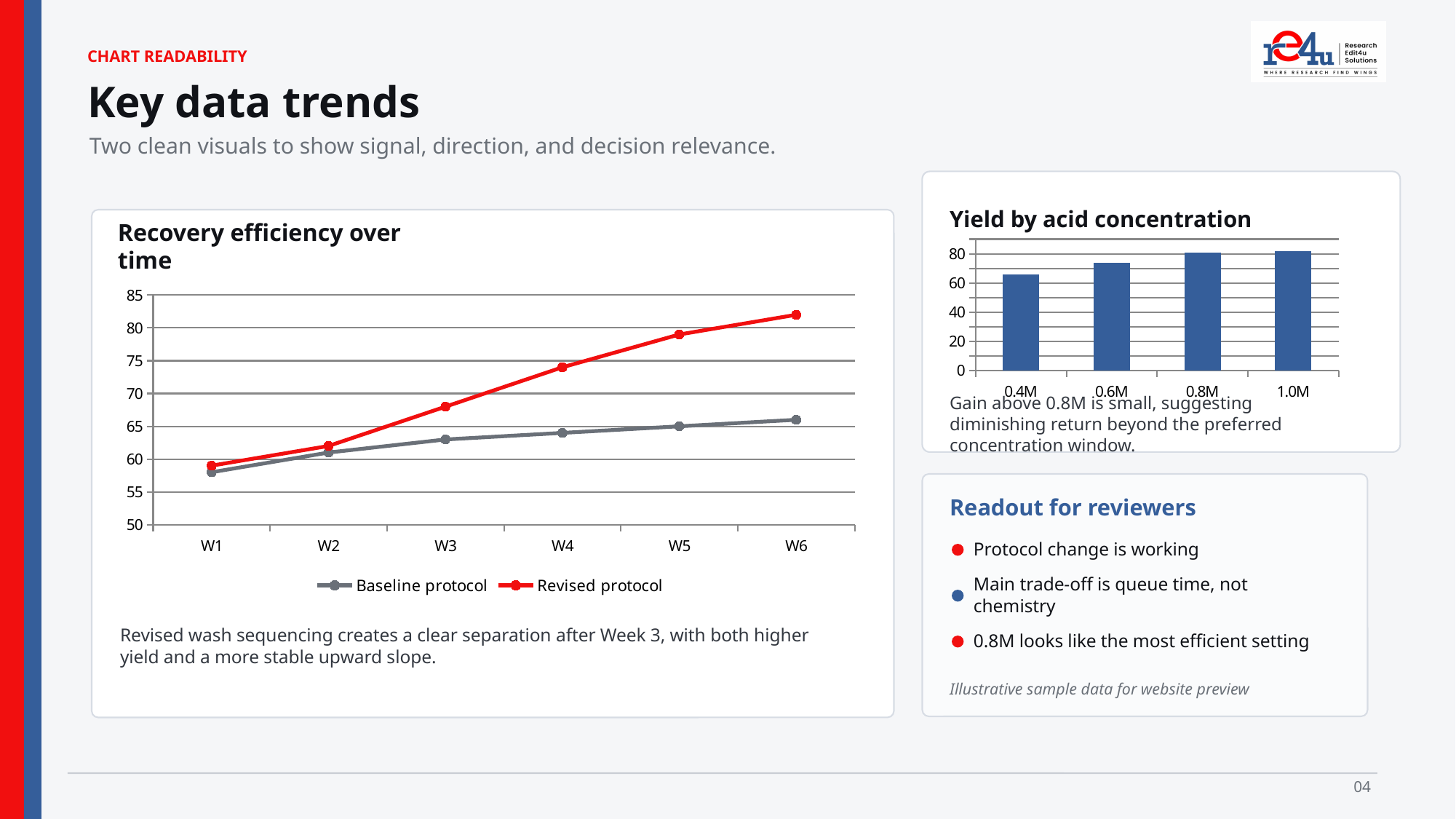
In "Recovery efficiency over time", how many points are plotted along the x axis for each series? 6 In "Recovery efficiency over time", which series has the higher value at W5? Revised protocol In "Recovery efficiency over time", how many series does the legend list? 2 What kind of chart is "Yield by acid concentration"? bar chart In "Yield by acid concentration", which concentration has the lowest yield? 0.4M In "Recovery efficiency over time", is the value for Revised protocol at W6 greater or less than 80? greater In "Yield by acid concentration", is the value for 0.6M greater or less than 80? less What kind of chart is "Recovery efficiency over time"? line chart In "Yield by acid concentration", how many bars are there? 4 In "Yield by acid concentration", which is larger, the value for 0.4M or the value for 0.8M? 0.8M In "Recovery efficiency over time", do the Revised protocol values rise or fall from W1 to W6? rise In "Recovery efficiency over time", is the value for Baseline protocol at W1 greater or less than 60? less